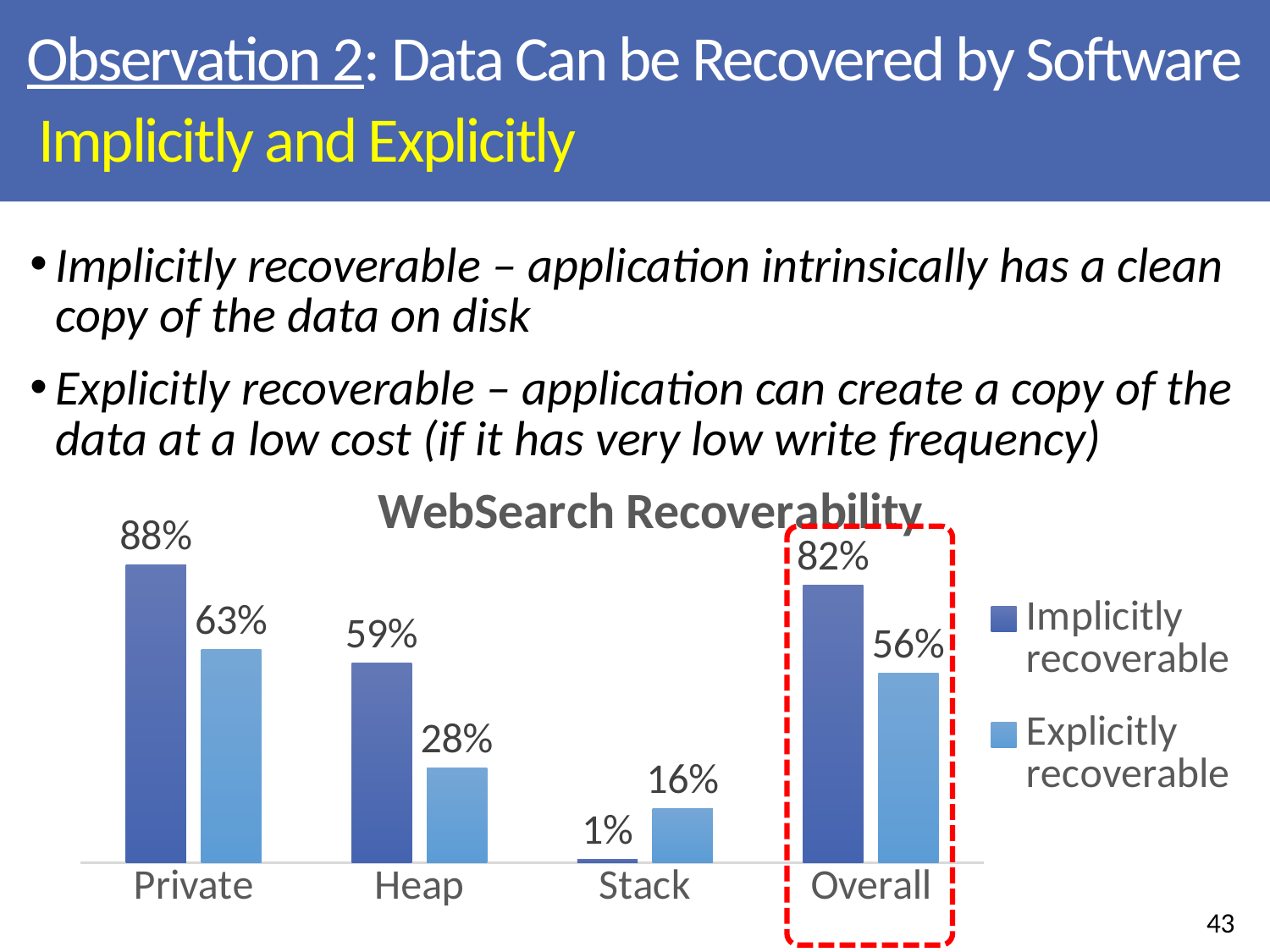
What is the Implicitly recoverable value for Private? 88% What is the Explicitly recoverable value for Heap? 28% Which category has the lowest Explicitly recoverable value? Stack What is the title of the chart? WebSearch Recoverability How many series does the legend list? 2 Which is larger for Stack: the Implicitly recoverable value or the Explicitly recoverable value? Explicitly recoverable What is the Explicitly recoverable value for Overall? 56% What is the difference between the Implicitly recoverable and Explicitly recoverable values for Overall? 26% What is the Implicitly recoverable value for Stack? 1% What kind of chart is shown? Bar chart How many categories are shown on the x axis? 4 Which category has the highest Implicitly recoverable value? Private